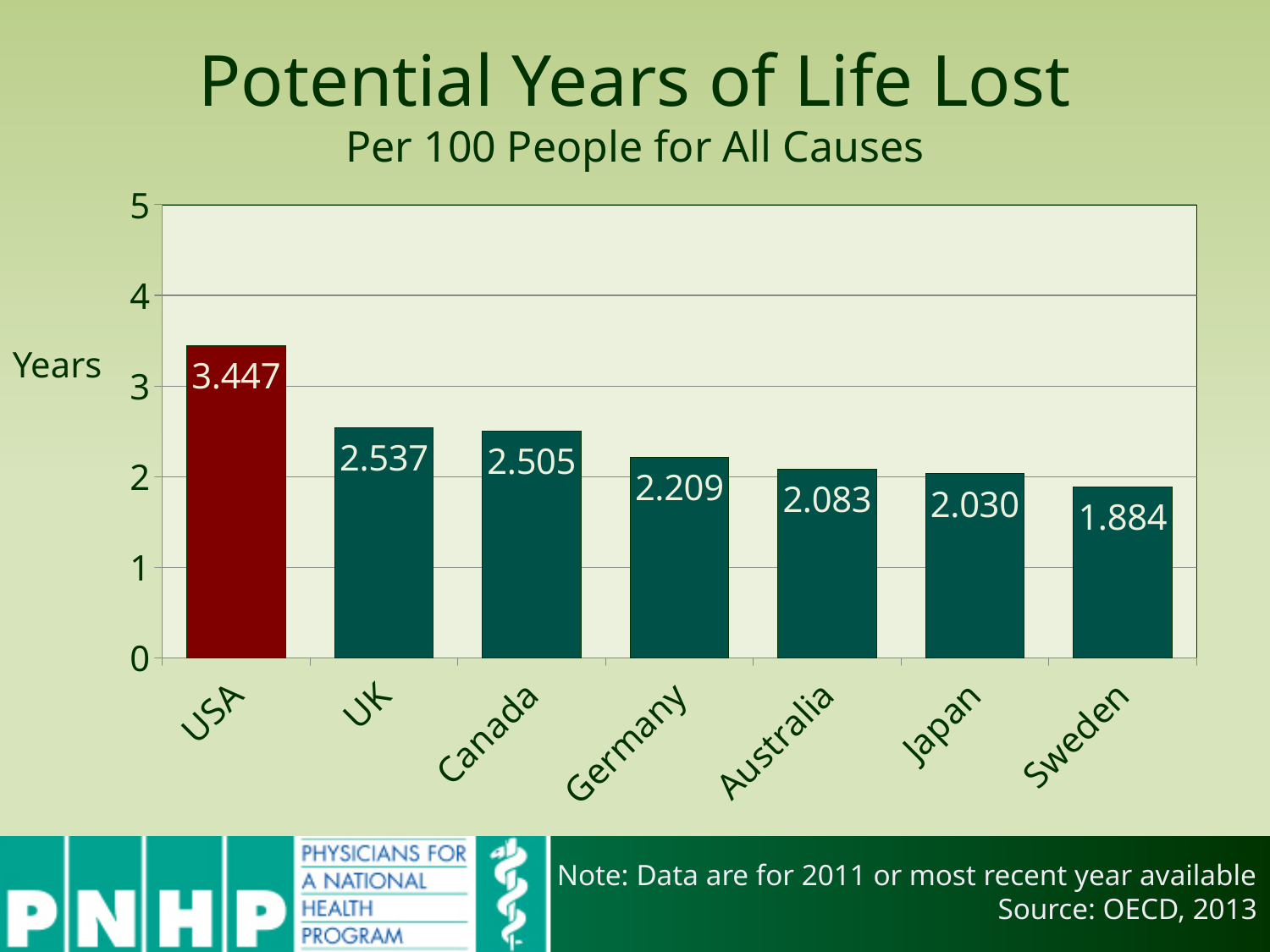
Which country has the highest potential years of life lost? USA What is the value for the USA? 3.447 Is the value for the USA greater or less than 3? greater Which has a larger value, Australia or Germany? Germany Which country has the lowest potential years of life lost? Sweden Which bar is coloured differently from the others? USA What is the difference between the values for the USA and the UK? 0.910 What kind of chart is shown on the slide? Bar chart How many countries are shown in the chart? 7 What is the value for Germany? 2.209 What is the difference between the values for Canada and Japan? 0.475 What is the value for Sweden? 1.884